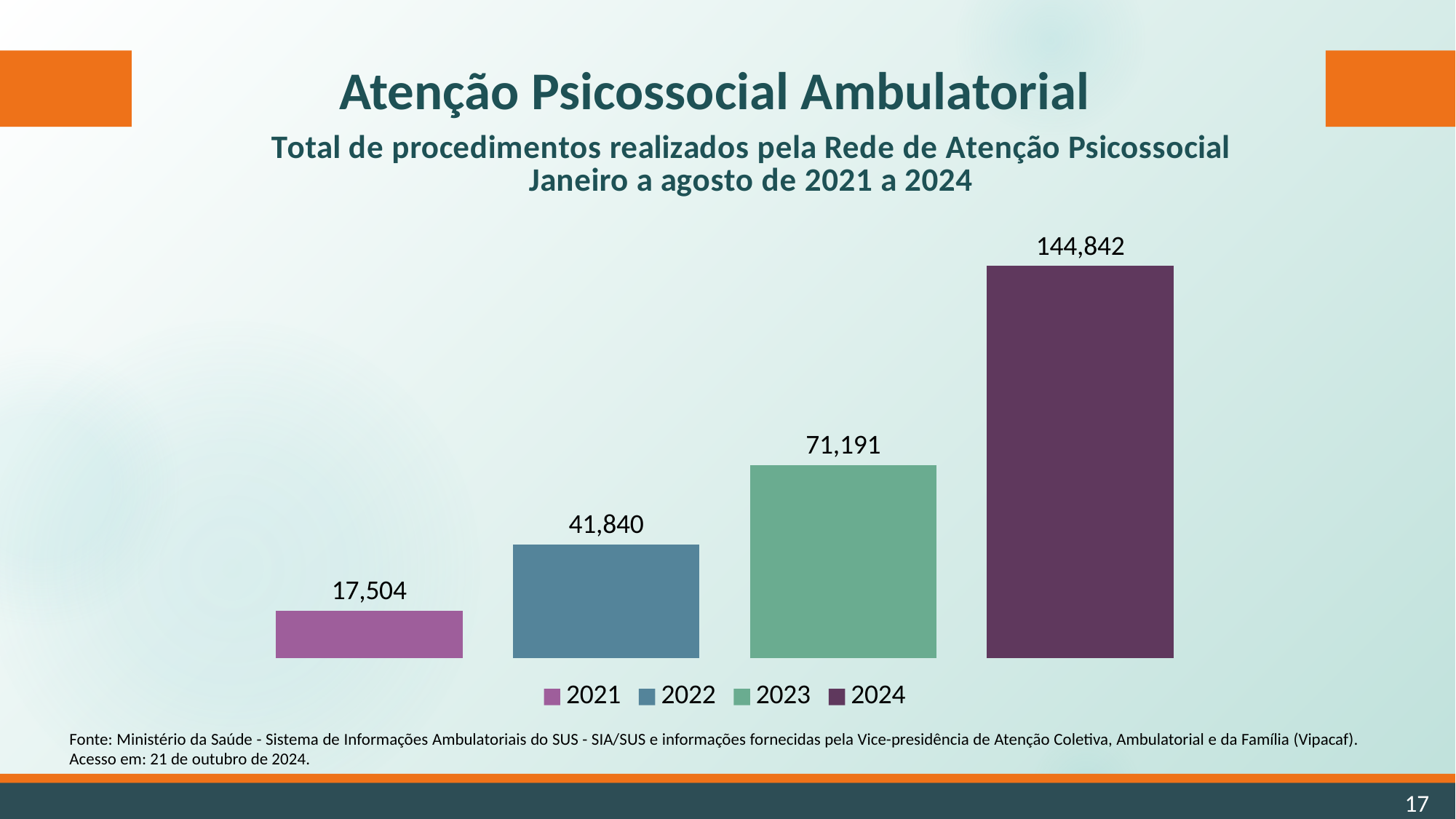
How many bars are shown in the chart? 4 What is the value shown for 2023? 71,191 What is the difference between the values for 2024 and 2023? 73,651 Which year has the highest value? 2024 Which year has the lowest value? 2021 What is the difference between the values for 2022 and 2021? 24,336 Do the values rise or fall from 2021 to 2024? Rise Which is larger, the value for 2022 or the value for 2023? 2023 What kind of chart is shown on the slide? Bar chart What is the value shown for 2021? 17,504 What is the value shown for 2024? 144,842 What is the value shown for 2022? 41,840